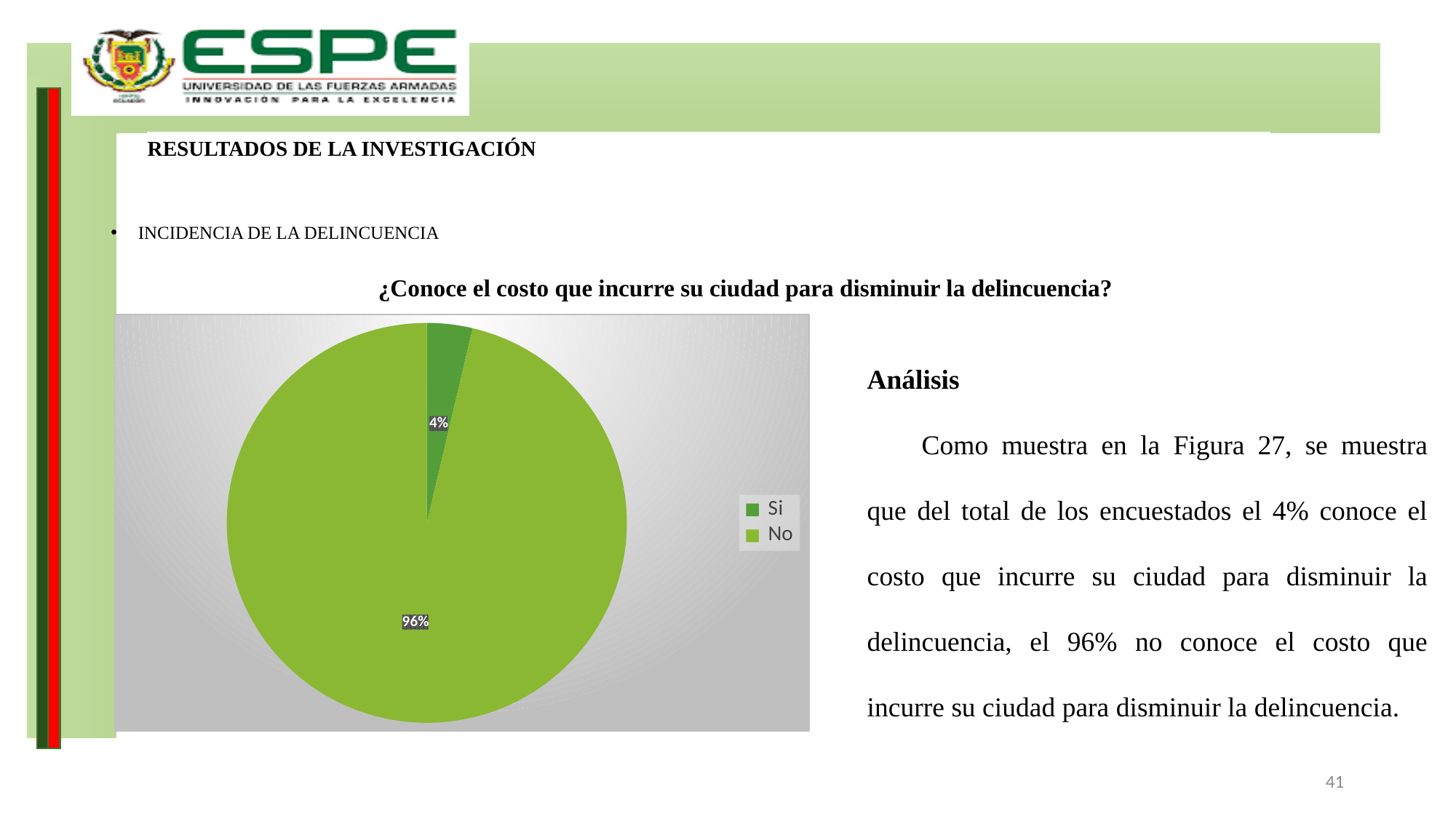
Which category has the smallest share of the pie? Si What percentage of respondents answered "Si"? 4% Which legend entry is shown in the darker green colour? Si Which slice is larger, "Si" or "No"? No Which category has the largest share of the pie? No What is the share of the pie taken by the "No" slice? 96% What question is the pie chart titled with? ¿Conoce el costo que incurre su ciudad para disminuir la delincuencia? What percentage of respondents answered "No"? 96% How many slices does the pie chart have? 2 How many entries does the legend list? 2 What is the difference in percentage points between the "No" and "Si" slices? 92 What kind of chart is shown on the slide? pie chart